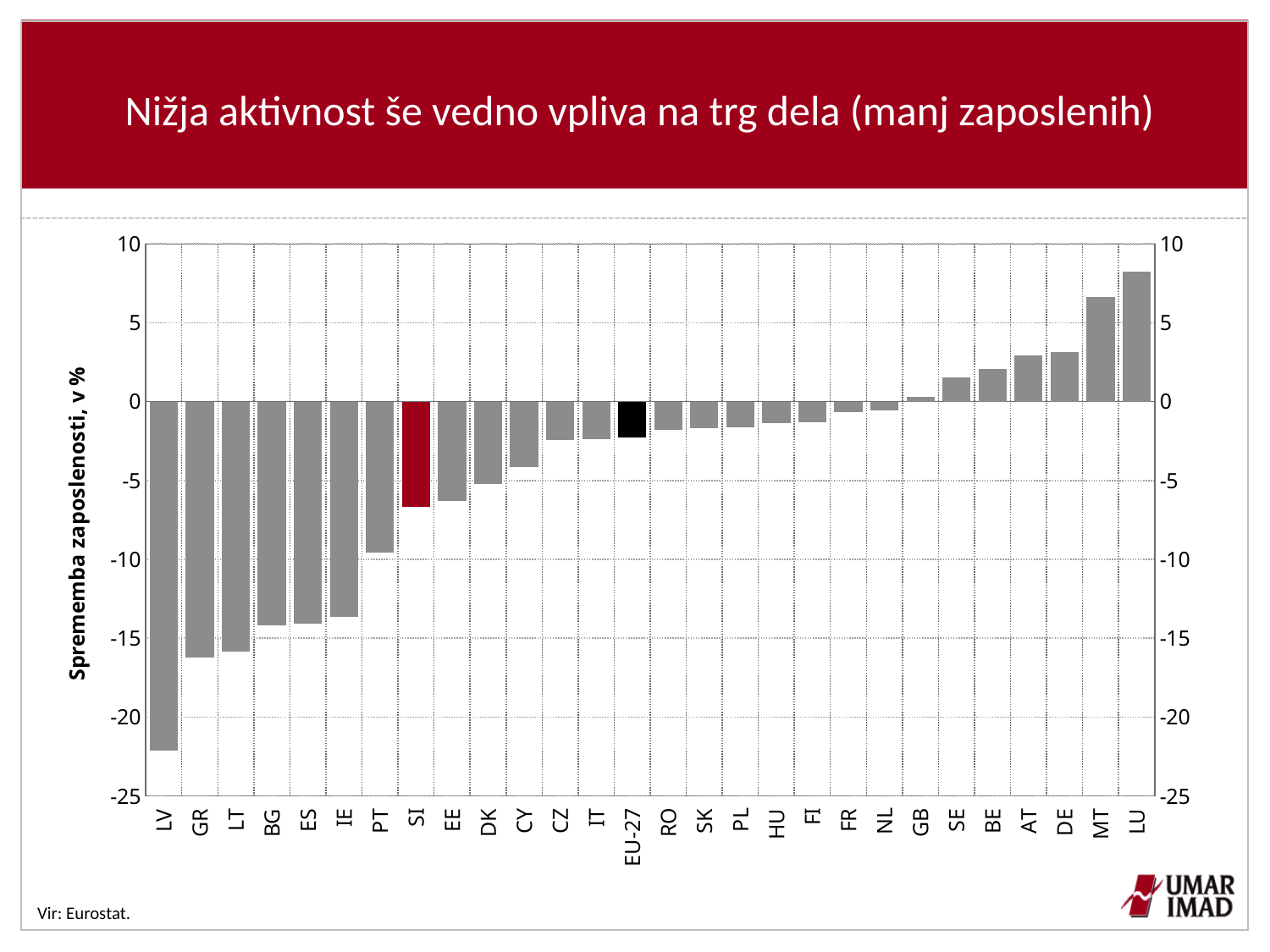
Which category's bar is highlighted in red? SI Is the value for LV greater or less than -20? less Which category has the highest value? LU Is the value for LU greater or less than 5? greater Which has the larger value, GR or PT? PT Do the values generally rise or fall moving from left to right along the x axis? rise What kind of chart is shown on the slide? bar chart Is the value for SI greater or less than -5? less How many countries/categories are plotted along the x axis? 28 Which has the larger value, MT or AT? MT Which category has the lowest value? LV